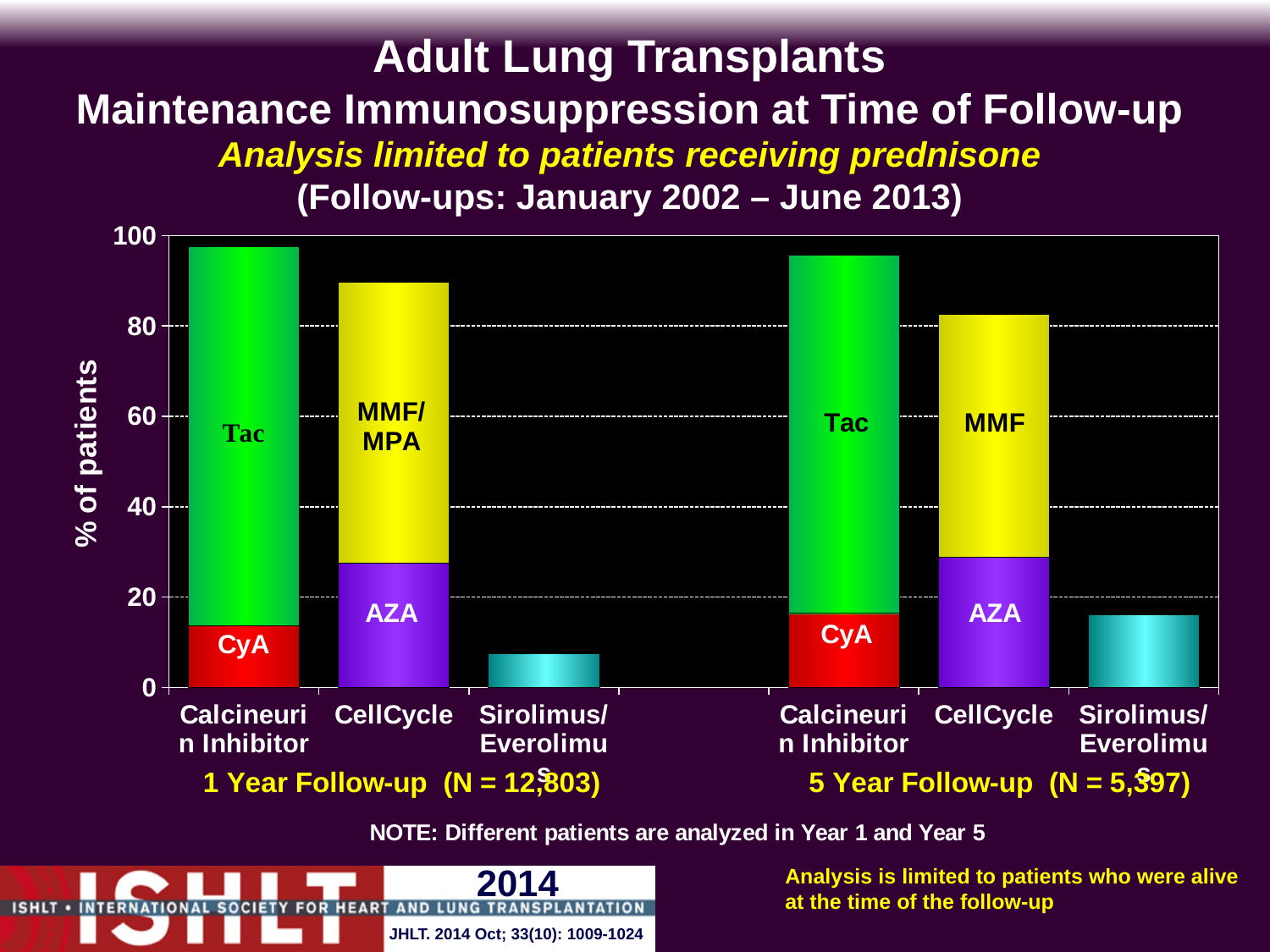
What is the label on the y axis? % of patients What kind of chart is shown on the slide? Stacked bar chart Is the value for Sirolimus/Everolimus at 1 Year Follow-up greater or less than 20? less What is the N for the 5 Year Follow-up group? 5,397 Which category has the tallest bar in the 1 Year Follow-up group? Calcineurin Inhibitor Which is larger at 5 Year Follow-up: the Calcineurin Inhibitor bar or the CellCycle bar? Calcineurin Inhibitor Which is larger: the Sirolimus/Everolimus bar at 1 Year Follow-up or at 5 Year Follow-up? 5 Year Follow-up How many categories are shown for the 1 Year Follow-up group? 3 Which category has the shortest bar in the 5 Year Follow-up group? Sirolimus/Everolimus Is the AZA segment of the CellCycle bar at 1 Year Follow-up greater or less than 40? less Is the total for Calcineurin Inhibitor at 1 Year Follow-up greater or less than 80? greater